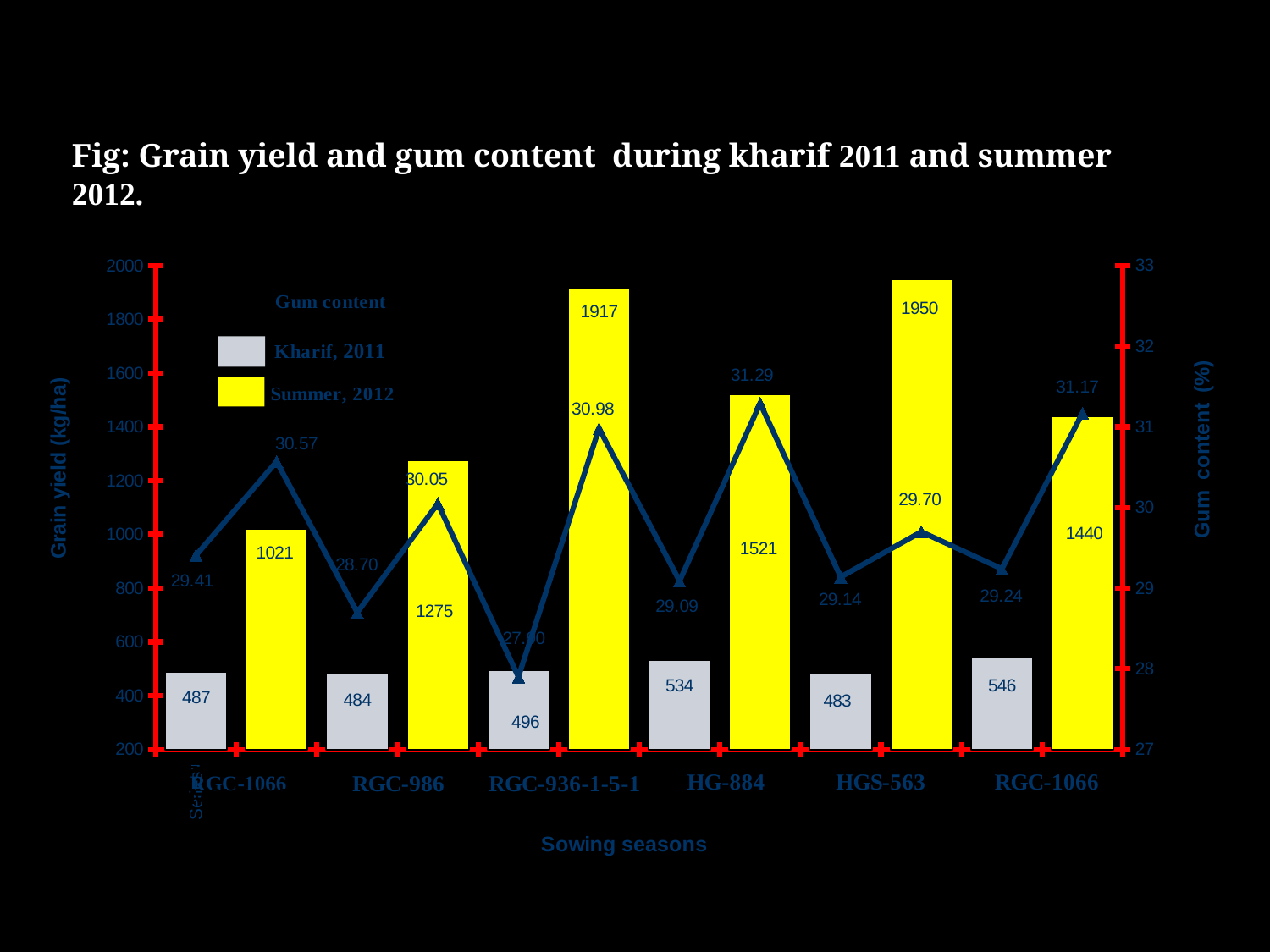
Is the Summer, 2012 grain yield for RGC-936-1-5-1 greater or less than 1800? greater Which genotype has the highest Summer, 2012 grain yield? HGS-563 What is the Kharif, 2011 grain yield for HG-884? 534 What is the difference between the Summer, 2012 and Kharif, 2011 grain yields for HGS-563? 1467 What is the Summer, 2012 grain yield for HGS-563? 1950 What is the difference between the Summer, 2012 grain yields of HGS-563 and RGC-936-1-5-1? 33 Which is larger, the Summer, 2012 grain yield for RGC-986 or for HG-884? HG-884 How many genotype categories are shown on the x axis? 6 What is the Kharif, 2011 grain yield for RGC-986? 484 How many series does the legend list? 2 What is the title of the right-hand vertical axis? Gum content (%) What gum content value is labelled on the line above the Summer, 2012 bar for HG-884? 31.29